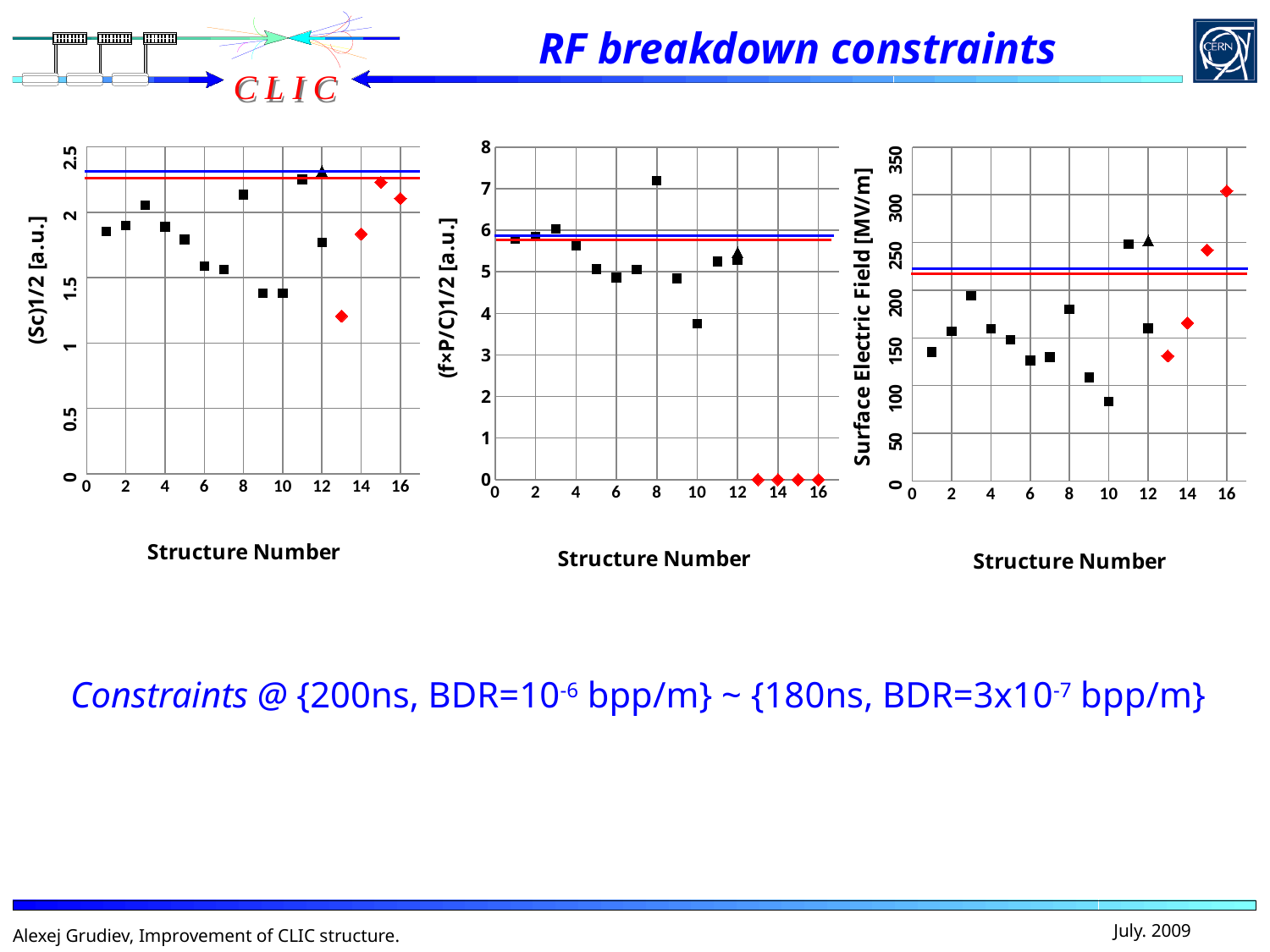
In the right chart, Surface Electric Field [MV/m], which is larger, the value for structure 3 or the value for structure 10? Structure 3 In the left chart, (Sc)1/2 [a.u.], which structure number has the lowest value? 13 How many charts are shown on the slide? 3 In the left chart, (Sc)1/2 [a.u.], is the value for structure 13 greater or less than 1.5? less What is the x-axis label shared by all three charts? Structure Number In the middle chart, (f×P/C)1/2 [a.u.], which structure number has the highest value? 8 In the right chart, Surface Electric Field [MV/m], which structure number has the highest value? 16 In the middle chart, (f×P/C)1/2 [a.u.], is the value for structure 10 greater or less than 4? less In the left chart, (Sc)1/2 [a.u.], is the value for structure 8 greater or less than 2? greater What kind of chart is the left chart, (Sc)1/2 [a.u.] versus Structure Number? Scatter chart What is the y-axis label of the right chart? Surface Electric Field [MV/m]